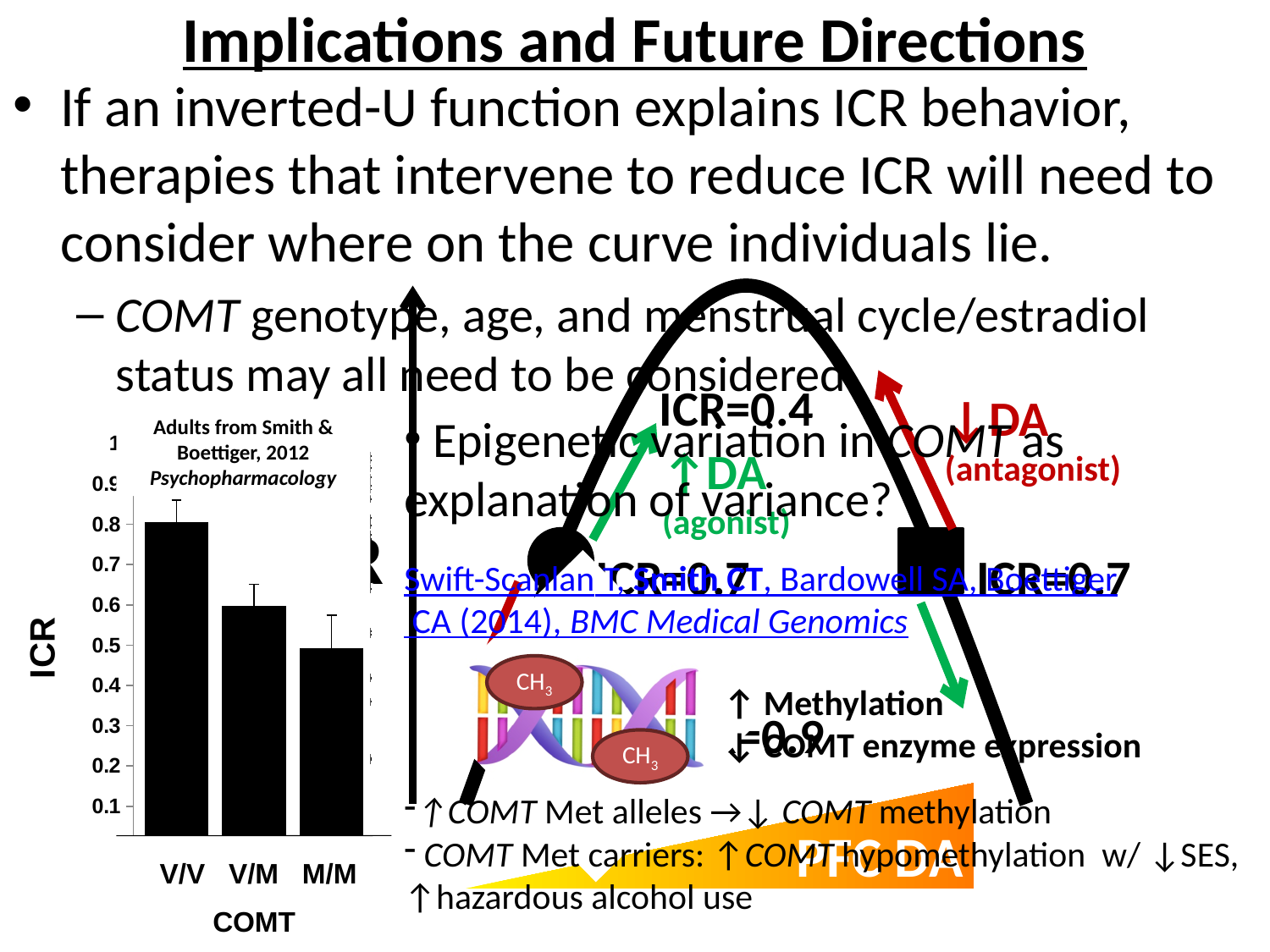
What kind of chart is shown at the bottom left of the slide (Adults from Smith & Boettiger, 2012)? bar chart In the bar chart, is the ICR value for V/M greater or less than 0.5? greater In the bar chart, is the ICR value for M/M greater or less than 0.6? less What is the label on the x axis of the bar chart? COMT In the bar chart, do the ICR values rise or fall going from V/V to M/M along the x axis? fall In the bar chart, which has the larger ICR value, V/V or M/M? V/V How many COMT genotype categories are plotted in the bar chart? 3 In the bar chart, which COMT genotype has the highest ICR? V/V In the bar chart, which COMT genotype has the lowest ICR? M/M In the bar chart, is the ICR value for V/V greater or less than 0.7? greater What is the label on the y axis of the bar chart? ICR